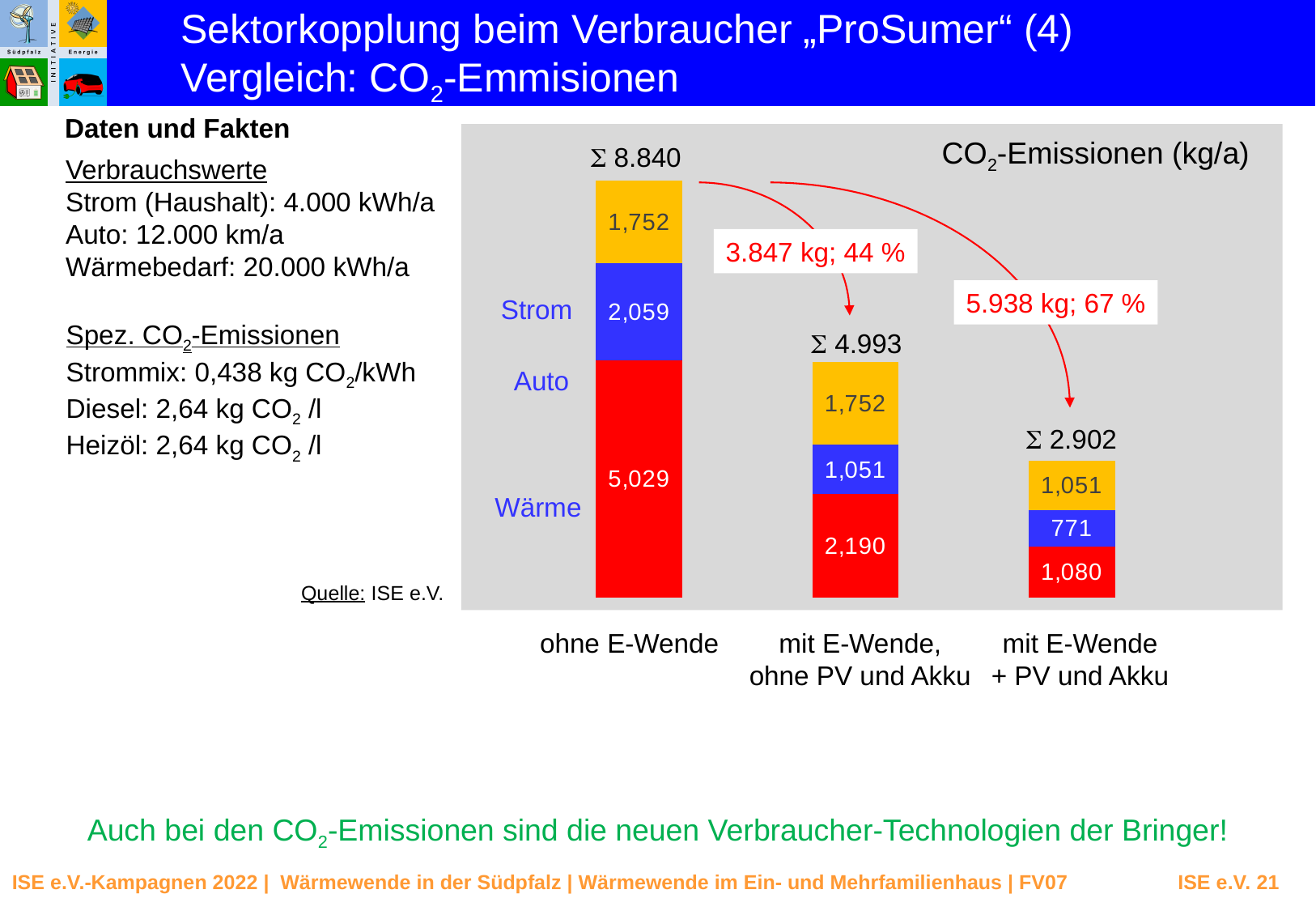
Which bar has the lowest total CO2 emissions? mit E-Wende + PV und Akku How many bars does the chart show? 3 What value is printed on the blue (middle) segment of the "mit E-Wende + PV und Akku" bar? 771 What is the total (Σ) shown above the "ohne E-Wende" bar? 8.840 What kind of chart is shown on the slide? stacked bar chart Which bar has the highest total CO2 emissions? ohne E-Wende By how many kg do emissions fall from "ohne E-Wende" to "mit E-Wende, ohne PV und Akku", according to the label on the arrow? 3.847 kg Is the red (bottom) segment larger in the "mit E-Wende, ohne PV und Akku" bar or in the "mit E-Wende + PV und Akku" bar? mit E-Wende, ohne PV und Akku Do the bar totals rise or fall from left to right across the chart? fall What value is printed on the yellow (top) segment of the "mit E-Wende, ohne PV und Akku" bar? 1,752 What value is printed on the red (bottom) segment of the "ohne E-Wende" bar? 5,029 What is the total (Σ) shown above the "mit E-Wende + PV und Akku" bar? 2.902